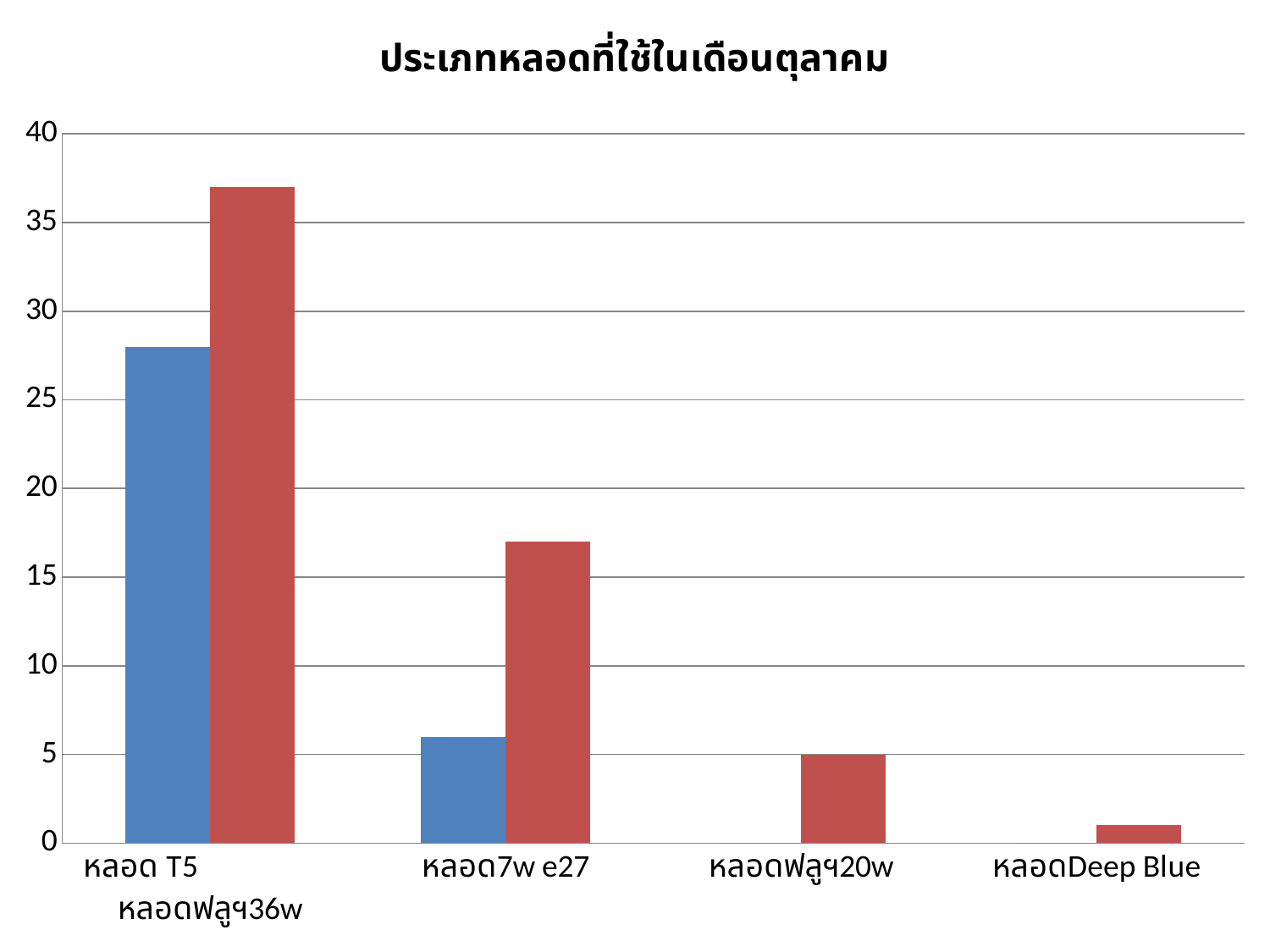
What is the title of the chart? ประเภทหลอดที่ใช้ในเดือนตุลาคม How many different bar colours are used in the chart? 2 Is the value of the red bar for หลอดDeep Blue greater or less than 5? less How many categories are shown on the x axis of the chart? 4 What kind of chart is shown on the slide? bar chart Is the value of the blue bar for หลอด T5 หลอดฟลูฯ36w greater or less than 30? less Which category has the tallest bar in the chart? หลอด T5 หลอดฟลูฯ36w Is the value of the red bar for หลอด7w e27 greater or less than 15? greater What is the value of the red bar for หลอดฟลูฯ20w? 5 Which category has the shortest bar in the chart? หลอดDeep Blue